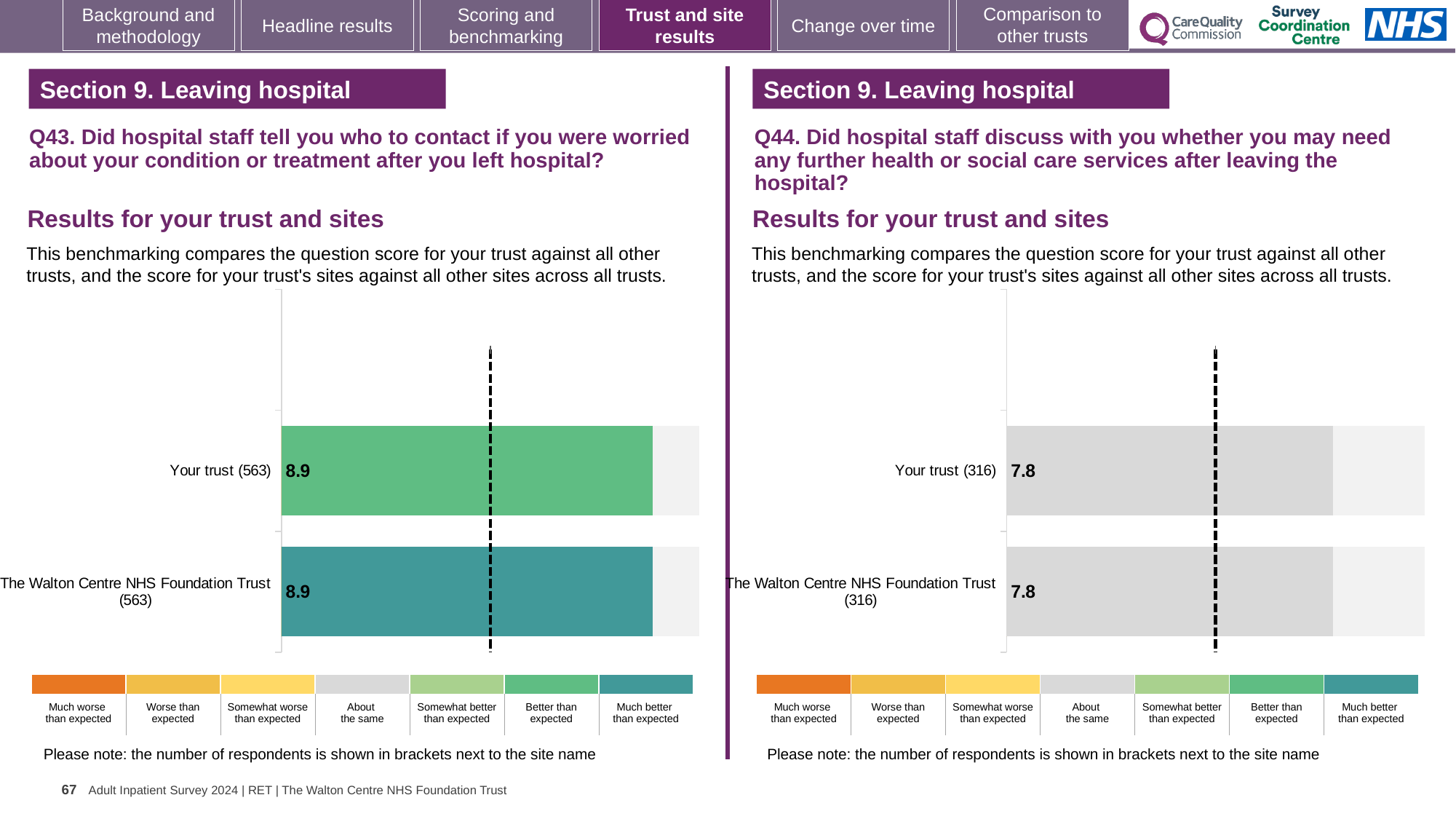
In the Q44 chart on the right, what is the difference between the score for Your trust and the score for The Walton Centre NHS Foundation Trust? 0.0 In the Q43 chart on the left, what is the difference between the score for Your trust and the score for The Walton Centre NHS Foundation Trust? 0.0 How many bars are plotted in the Q43 chart on the left? 2 In the Q44 chart on the right, which benchmark category does the colour of the Your trust bar correspond to? About the same In the Q44 chart on the right, what is the score for Your trust (316)? 7.8 What kind of chart is used for the Q43 results on the left? Bar chart In the Q43 chart on the left, what is the score for The Walton Centre NHS Foundation Trust (563)? 8.9 How many respondents are shown in brackets for Your trust in the Q44 chart on the right? 316 In the Q44 chart on the right, what is the score for The Walton Centre NHS Foundation Trust (316)? 7.8 In the Q43 chart on the left, what is the score for Your trust (563)? 8.9 How many bars are plotted in the Q44 chart on the right? 2 In the Q43 chart on the left, which benchmark category does the colour of the Walton Centre NHS Foundation Trust bar correspond to? Much better than expected